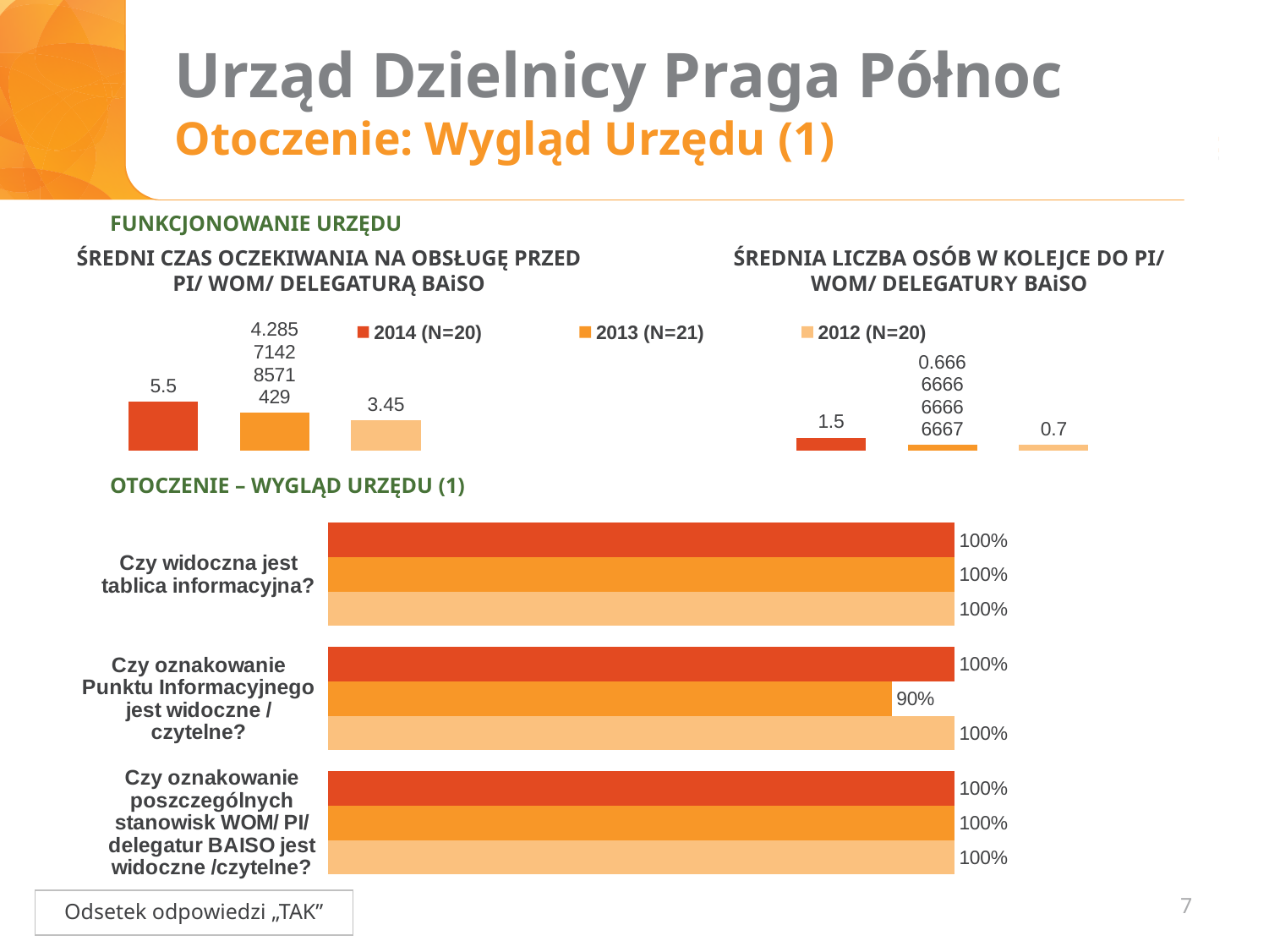
In the chart titled "ŚREDNI CZAS OCZEKIWANIA NA OBSŁUGĘ PRZED PI/ WOM/ DELEGATURĄ BAiSO", what is the value for 2014 (N=20)? 5.5 What type of chart is shown under "OTOCZENIE – WYGLĄD URZĘDU (1)"? Bar chart In the chart titled "ŚREDNIA LICZBA OSÓB W KOLEJCE DO PI/ WOM/ DELEGATURY BAiSO", what is the value for 2014 (N=20)? 1.5 In the chart under "OTOCZENIE – WYGLĄD URZĘDU (1)", what is the 2014 value for "Czy widoczna jest tablica informacyjna?"? 100% In the chart titled "ŚREDNIA LICZBA OSÓB W KOLEJCE DO PI/ WOM/ DELEGATURY BAiSO", which year has the highest value? 2014 (N=20) In the chart titled "ŚREDNIA LICZBA OSÓB W KOLEJCE DO PI/ WOM/ DELEGATURY BAiSO", what is the value for 2012 (N=20)? 0.7 In the chart titled "ŚREDNI CZAS OCZEKIWANIA NA OBSŁUGĘ PRZED PI/ WOM/ DELEGATURĄ BAiSO", what is the difference between the 2014 and 2012 values? 2.05 In the chart titled "ŚREDNI CZAS OCZEKIWANIA NA OBSŁUGĘ PRZED PI/ WOM/ DELEGATURĄ BAiSO", what is the value for 2012 (N=20)? 3.45 In the chart titled "ŚREDNI CZAS OCZEKIWANIA NA OBSŁUGĘ PRZED PI/ WOM/ DELEGATURĄ BAiSO", which year has the highest value? 2014 (N=20) How many question categories are shown in the chart under "OTOCZENIE – WYGLĄD URZĘDU (1)"? 3 How many series does the legend list for the charts in the "FUNKCJONOWANIE URZĘDU" section? 3 In the chart under "OTOCZENIE – WYGLĄD URZĘDU (1)", what is the 2013 value for "Czy oznakowanie Punktu Informacyjnego jest widoczne / czytelne?"? 90%